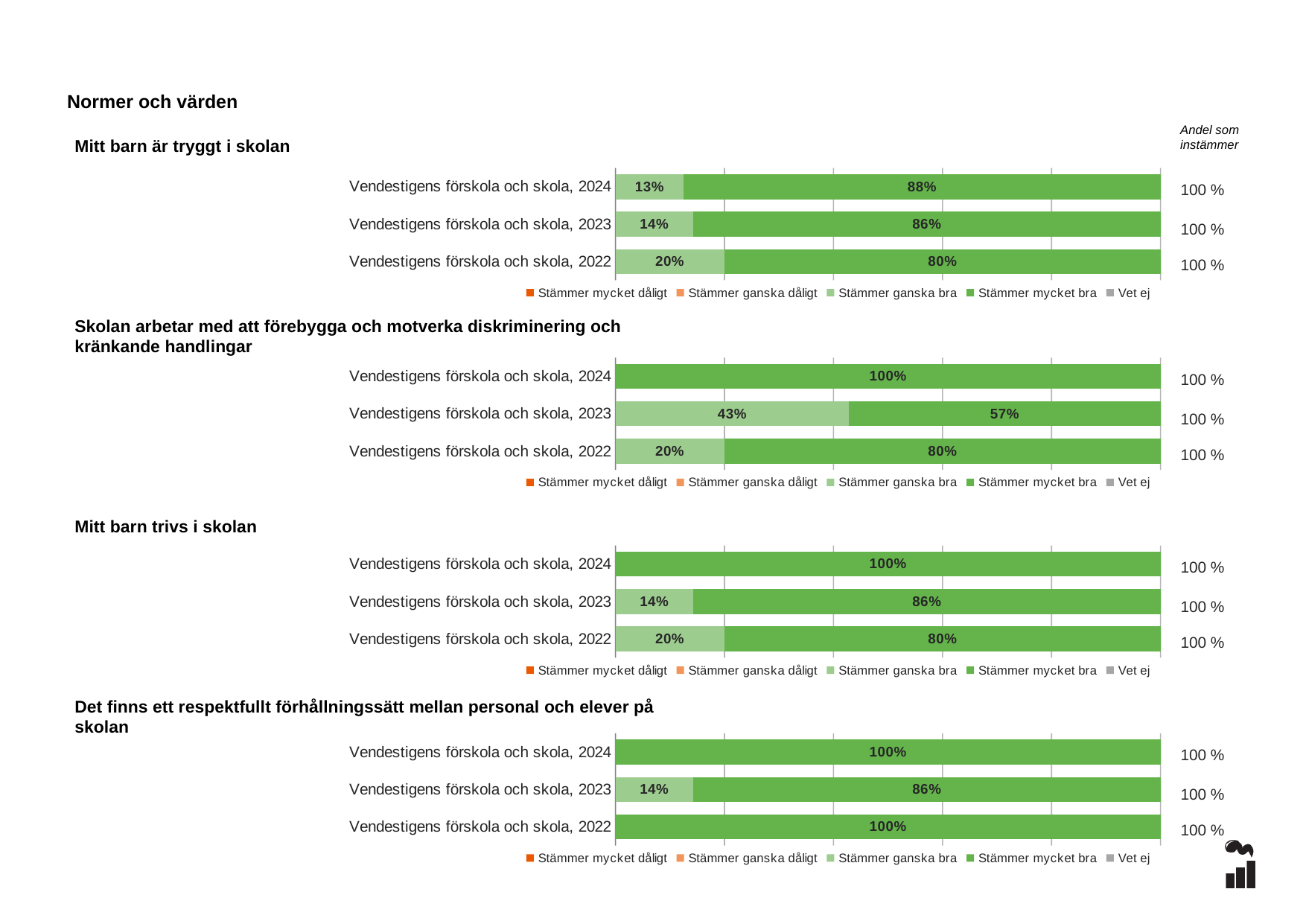
In the chart 'Skolan arbetar med att förebygga och motverka diskriminering och kränkande handlingar', which year has the lowest 'Stämmer mycket bra' value? 2023 How many series does the legend of the chart 'Mitt barn trivs i skolan' list? 5 What type of chart is used for 'Mitt barn är tryggt i skolan'? Stacked bar chart In the chart 'Mitt barn är tryggt i skolan', what is the 'Stämmer ganska bra' value for Vendestigens förskola och skola, 2022? 20% In the chart 'Mitt barn är tryggt i skolan', what is the 'Stämmer mycket bra' value for Vendestigens förskola och skola, 2024? 88% In the chart 'Mitt barn trivs i skolan', what is the difference between the 'Stämmer mycket bra' values for 2024 and 2023? 14 percentage points In the chart 'Det finns ett respektfullt förhållningssätt mellan personal och elever på skolan', what is the 'Stämmer mycket bra' value for 2022? 100% In the chart 'Skolan arbetar med att förebygga och motverka diskriminering och kränkande handlingar', which year has the highest 'Stämmer mycket bra' value? 2024 In the chart 'Skolan arbetar med att förebygga och motverka diskriminering och kränkande handlingar', what is the 'Stämmer ganska bra' value for 2023? 43% In the chart 'Mitt barn trivs i skolan', is the 'Stämmer mycket bra' value larger for 2023 or for 2022? 2023 How many bars (years) does the chart 'Mitt barn är tryggt i skolan' show? 3 In the chart 'Det finns ett respektfullt förhållningssätt mellan personal och elever på skolan', what is the 'Stämmer ganska bra' value for 2023? 14%